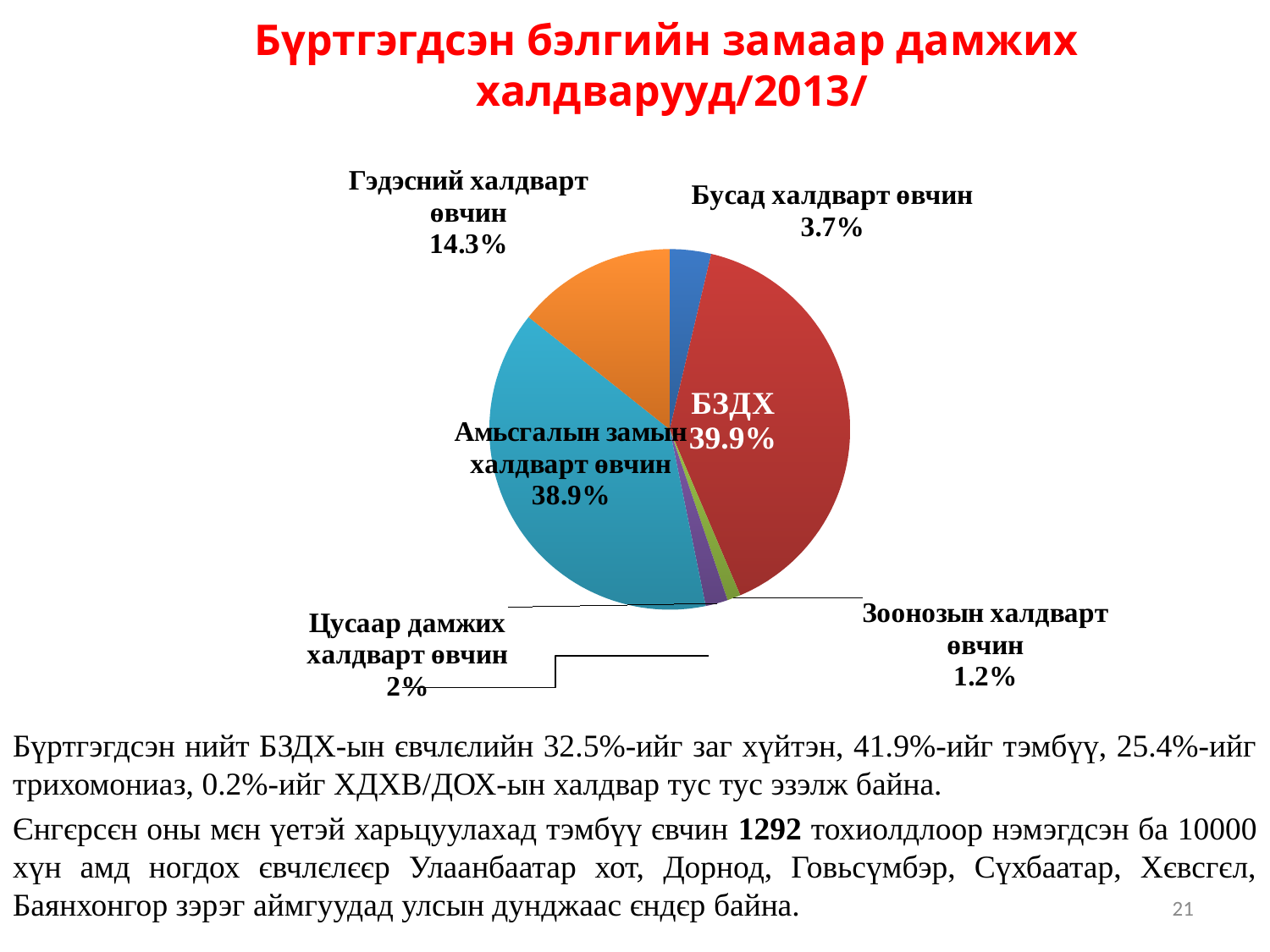
What is the difference between the shares of БЗДХ and Амьсгалын замын халдварт өвчин? 1.0% What is the value shown for Зоонозын халдварт өвчин? 1.2% What is the value shown for Гэдэсний халдварт өвчин? 14.3% What is the value shown for Цусаар дамжих халдварт өвчин? 2% How many slices does the pie chart have? 6 What kind of chart is shown on the slide? Pie chart Which is larger, the share for Гэдэсний халдварт өвчин or the share for Бусад халдварт өвчин? Гэдэсний халдварт өвчин What share of the pie does БЗДХ account for? 39.9% What is the value shown for Амьсгалын замын халдварт өвчин? 38.9% What is the value shown for Бусад халдварт өвчин? 3.7% Which category has the smallest share of the pie? Зоонозын халдварт өвчин Which category has the largest share of the pie? БЗДХ